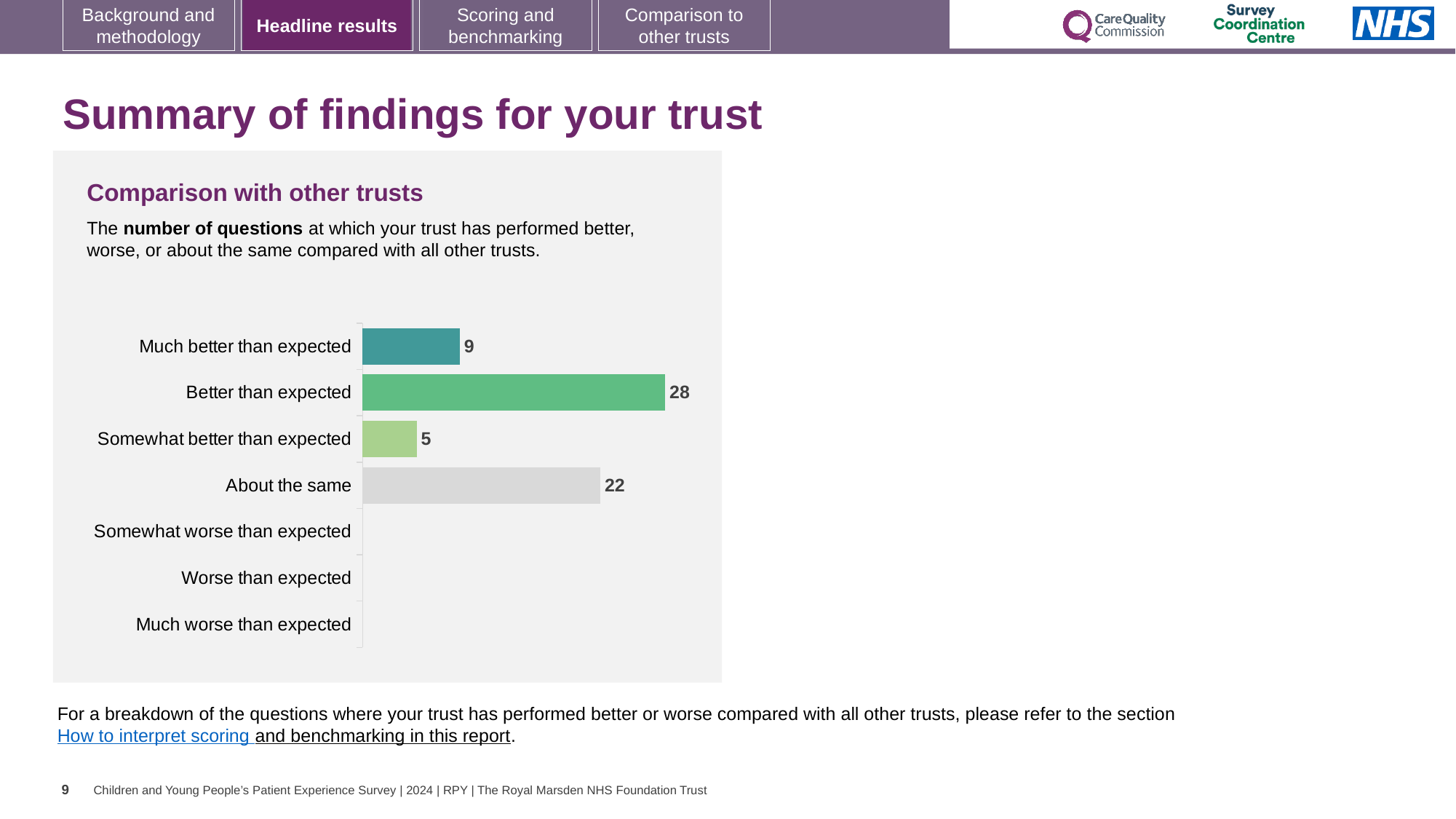
What is the value for 'Better than expected'? 28 What type of chart is shown? Bar chart How many categories are listed on the chart's axis? 7 What is the title of the chart section? Comparison with other trusts Which category has the highest number of questions? Better than expected How many questions are 'About the same'? 22 Among the categories with a visible bar, which has the lowest value? Somewhat better than expected Which is larger: 'About the same' or 'Much better than expected'? About the same What is the difference between 'Better than expected' and 'About the same'? 6 What is the value for 'Somewhat better than expected'? 5 What is the difference between 'Much better than expected' and 'Somewhat better than expected'? 4 How many questions are in the 'Much better than expected' category? 9